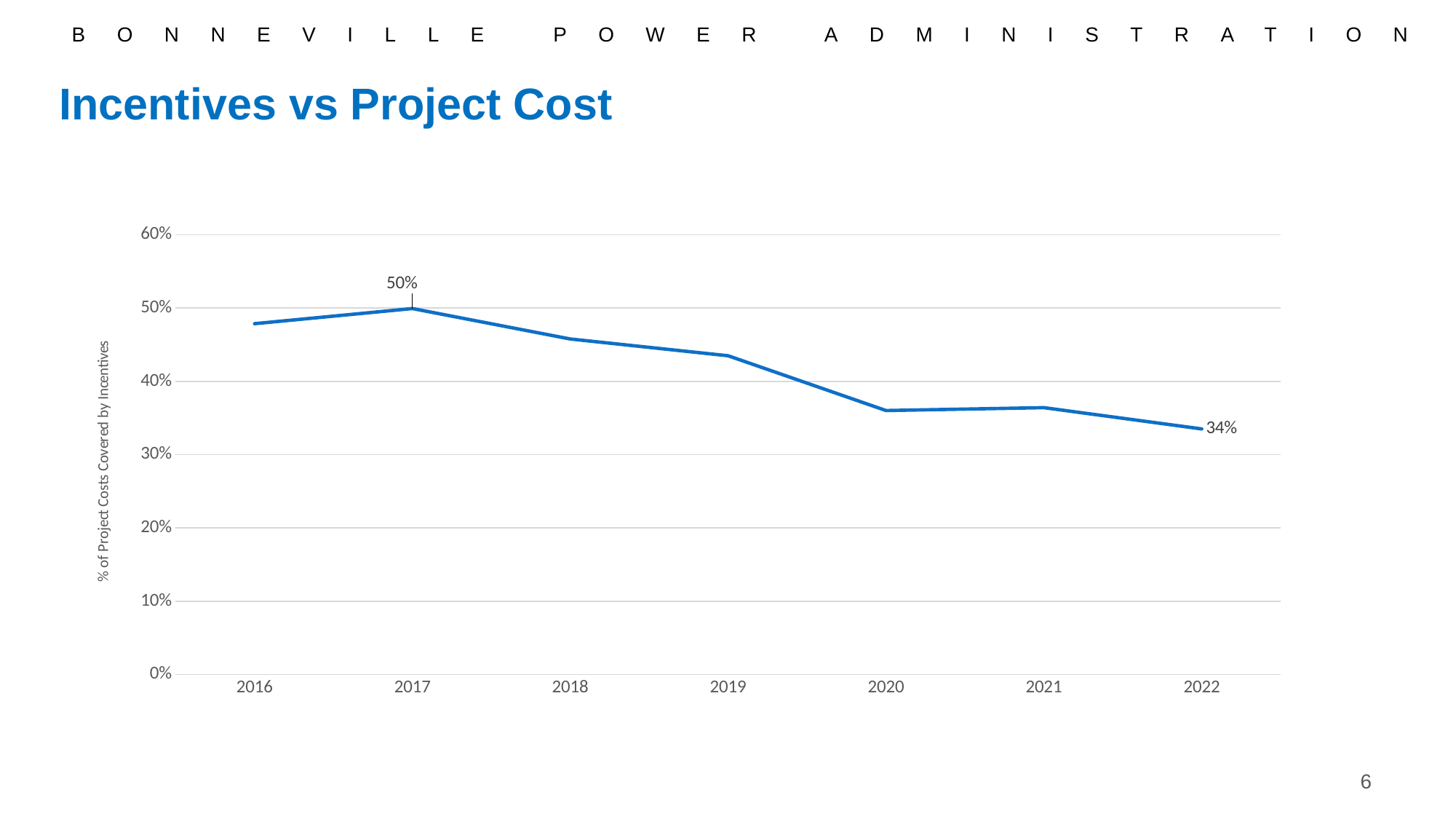
What is the value for 2017? 50% Do the values generally rise or fall from 2017 to 2022? fall Is the value for 2020 greater or less than 40%? less Which year has the lowest value? 2022 Is the value for 2019 greater or less than 40%? greater What is the label on the y axis? % of Project Costs Covered by Incentives What kind of chart is shown? line chart Which year has the highest value? 2017 What is the difference between the 2017 value and the 2022 value? 16% How many years are plotted on the x axis? 7 Which is larger, the value for 2016 or the value for 2020? 2016 What is the value for 2022? 34%